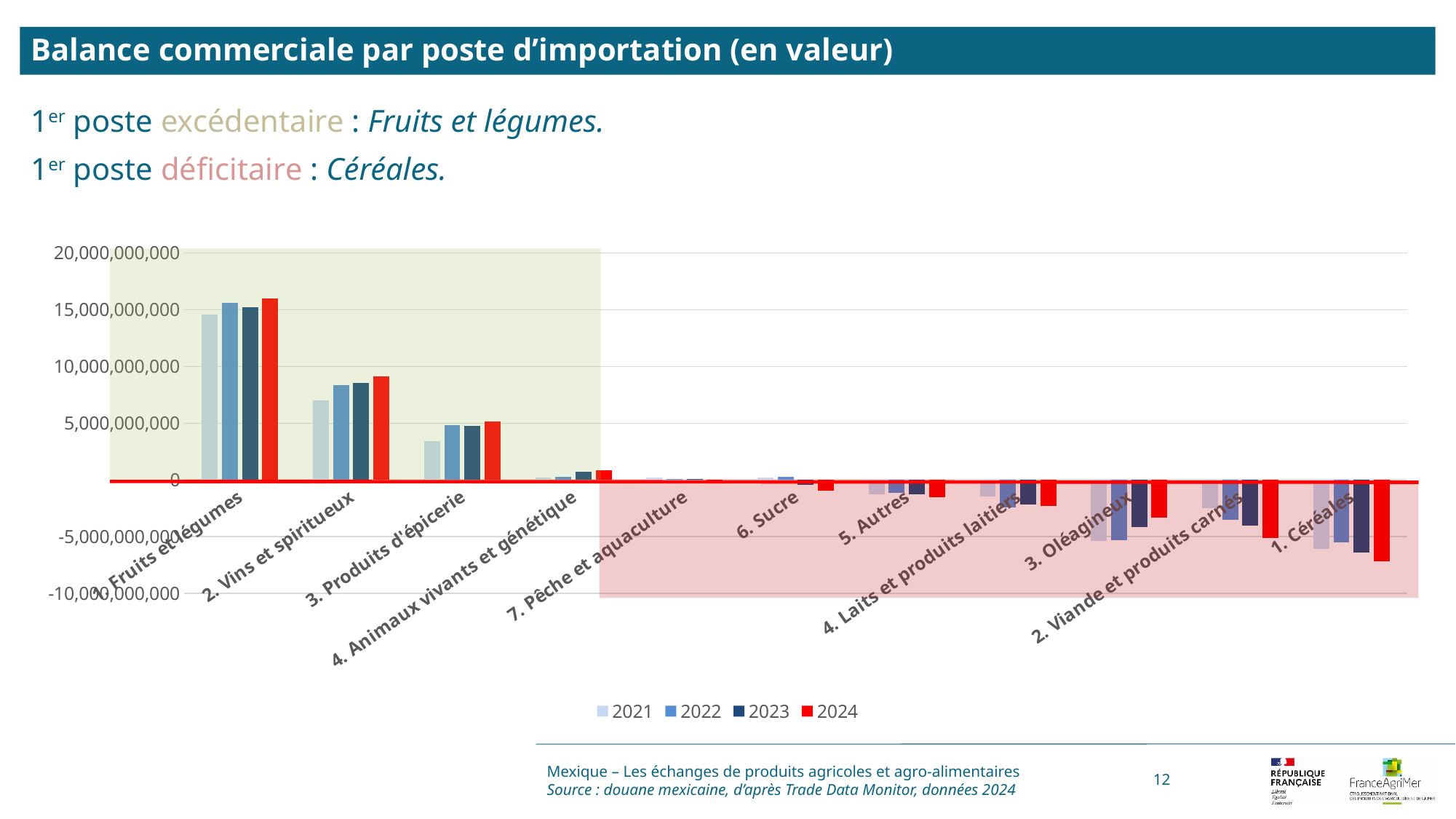
How many series does the legend list? 4 What kind of chart is shown on the slide? Bar chart Is the 2024 value for 1. Fruits et légumes greater or less than 15,000,000,000? greater Which is larger in 2024: 1. Fruits et légumes or 2. Vins et spiritueux? 1. Fruits et légumes Which category has the highest 2024 value? 1. Fruits et légumes Is the 2024 value for 3. Oléagineux greater or less than -5,000,000,000? greater Is the 2024 value for 1. Céréales greater or less than -5,000,000,000? less Do the values for 2. Vins et spiritueux rise or fall from 2021 to 2024? rise Which colour represents the 2024 series in the legend? Red Which category has the lowest 2024 value? 1. Céréales How many categories are shown on the x axis of the chart? 11